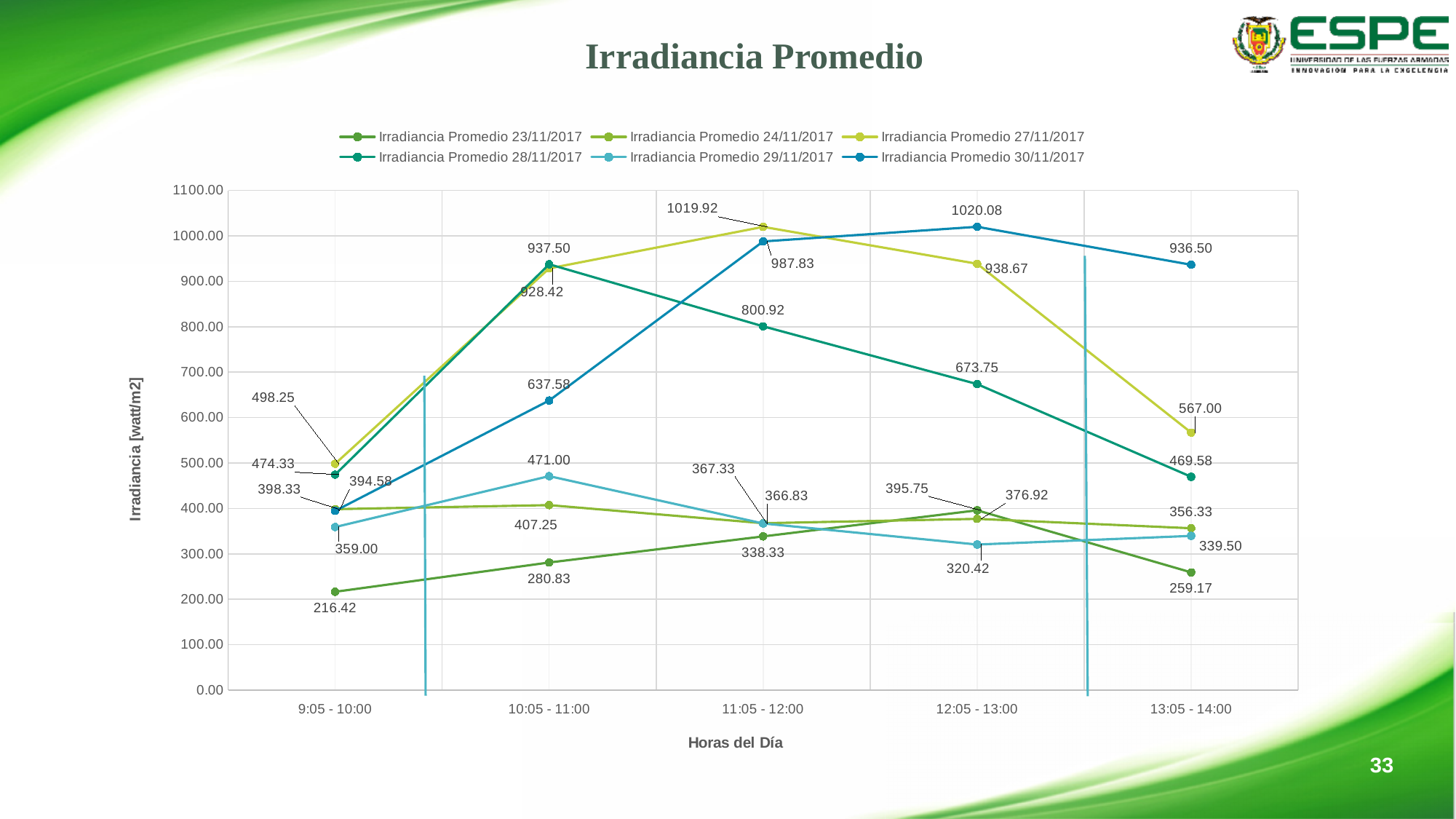
How many series does the legend list? 6 In which time slot does Irradiancia Promedio 23/11/2017 reach its highest value? 12:05 - 13:00 What is the value of Irradiancia Promedio 23/11/2017 at 9:05 - 10:00? 216.42 What is the value of Irradiancia Promedio 28/11/2017 at 11:05 - 12:00? 800.92 How many time slots are shown on the x axis? 5 What is the value of Irradiancia Promedio 30/11/2017 at 12:05 - 13:00? 1020.08 What is the value of Irradiancia Promedio 27/11/2017 at 13:05 - 14:00? 567.00 At 12:05 - 13:00, which is larger: Irradiancia Promedio 28/11/2017 or Irradiancia Promedio 30/11/2017? Irradiancia Promedio 30/11/2017 What kind of chart is shown on the slide? Line chart In which time slot does Irradiancia Promedio 30/11/2017 have its lowest value? 9:05 - 10:00 What is the value of Irradiancia Promedio 29/11/2017 at 10:05 - 11:00? 471.00 What is the difference between the Irradiancia Promedio 30/11/2017 values at 12:05 - 13:00 and 13:05 - 14:00? 83.58